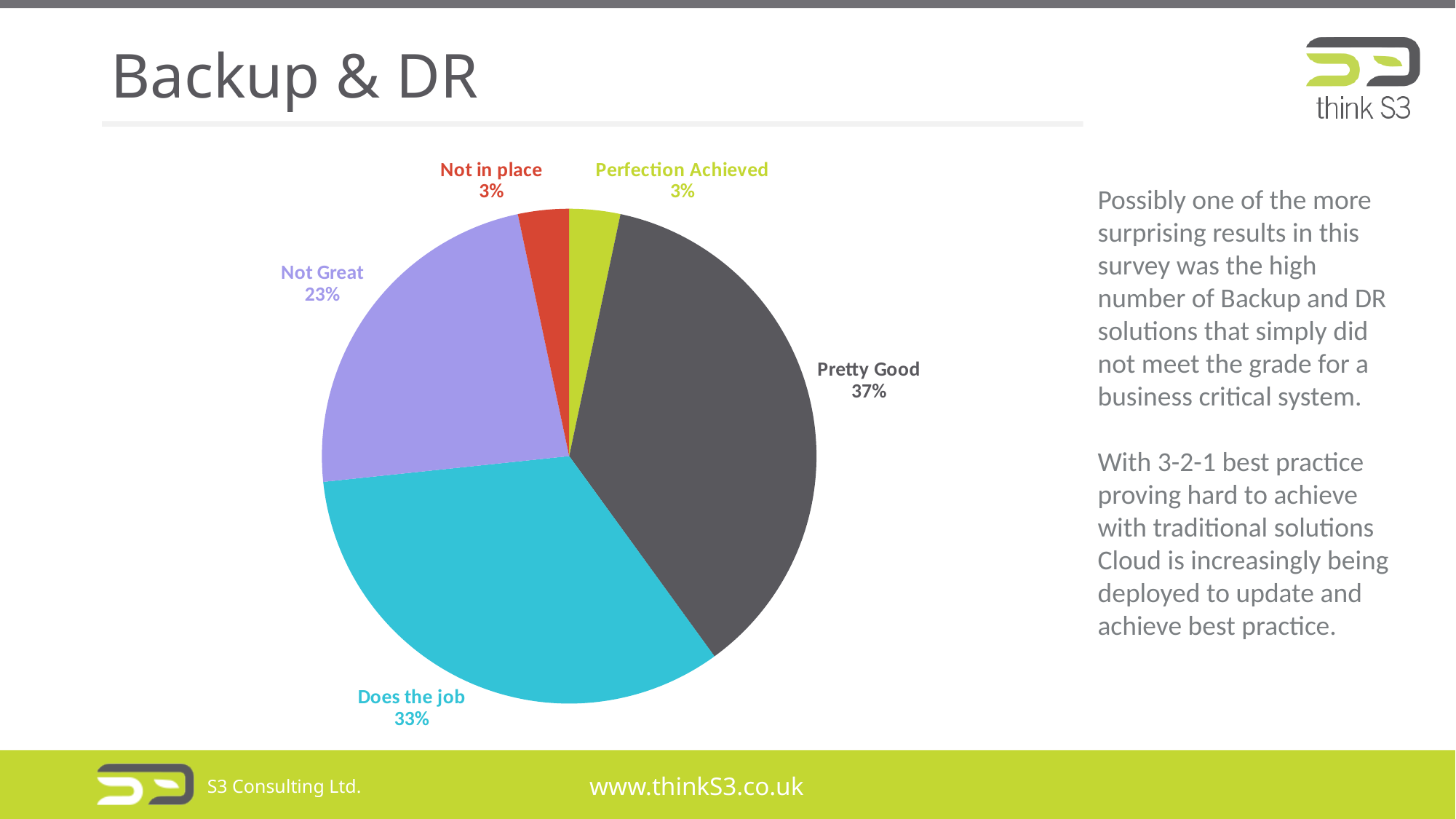
What is the difference in percentage points between "Pretty Good" and "Does the job"? 4% What share of the pie does "Not Great" represent? 23% What share of the pie does "Does the job" represent? 33% Which is larger, the share for "Not Great" or the share for "Does the job"? Does the job What share of the pie does "Pretty Good" represent? 37% Which category has the largest slice of the pie? Pretty Good What kind of chart is shown on the slide? Pie chart How many categories are shown in the pie chart? 5 What is the difference in percentage points between "Does the job" and "Not Great"? 10% What colour is the "Does the job" slice? Teal/cyan